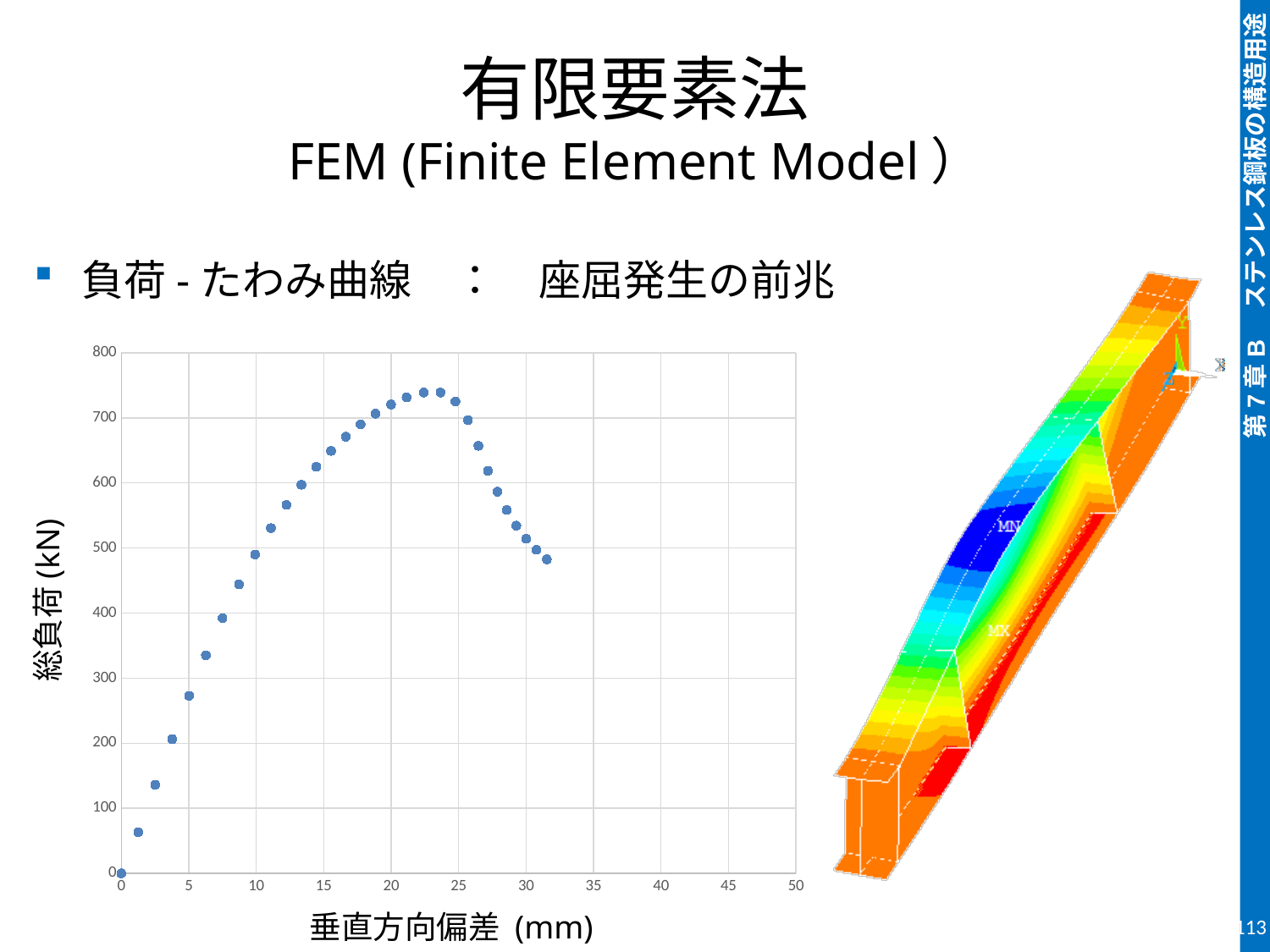
Is the load value at a vertical deflection of about 2.5 mm greater or less than 200 kN? less What is the title of the vertical axis of the chart? 総負荷 (kN) What is the title of the horizontal axis of the chart? 垂直方向偏差 (mm) What is the maximum value shown on the vertical axis of the chart? 800 Is the load value at a vertical deflection of about 20 mm greater or less than 700 kN? greater What kind of chart is shown on the slide? scatter chart Around which vertical deflection does the total load reach its peak: about 10 mm or about 23 mm? about 23 mm Is the highest plotted load value greater or less than 700 kN? greater How does the total load change as the vertical deflection increases along the x axis? rises to a peak, then falls Which is larger, the load at a deflection of about 10 mm or the load at a deflection of about 20 mm? about 20 mm